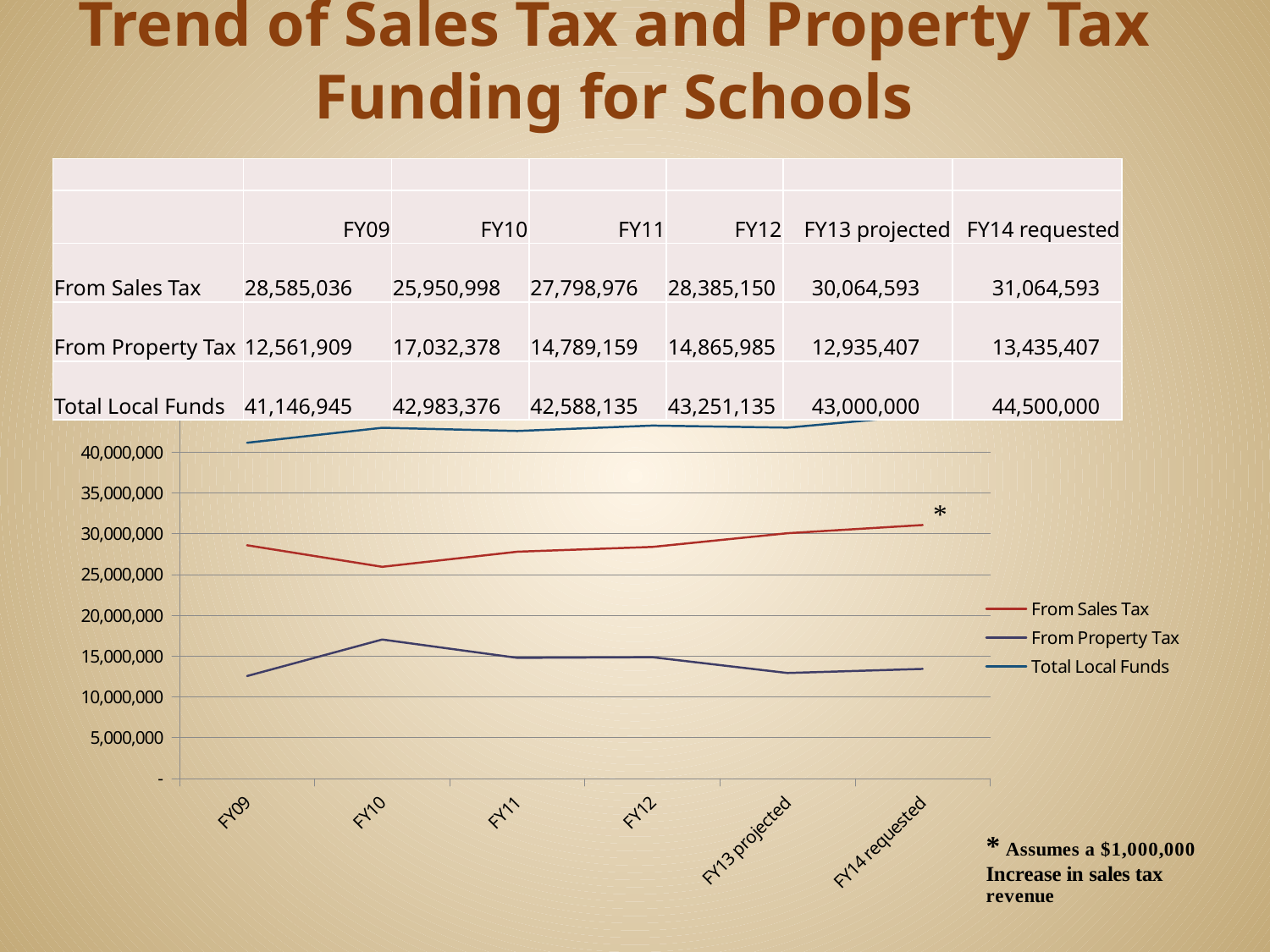
What is the value for From Sales Tax in FY12? 28,385,150 How many fiscal-year categories are plotted along the x axis? 6 In which fiscal year is From Sales Tax lowest? FY10 What is the value for From Property Tax in FY13 projected? 12,935,407 In which fiscal year is From Property Tax highest? FY10 What type of chart is shown on the slide? line chart What is the difference between From Sales Tax in FY14 requested and FY13 projected? 1,000,000 What is the value for Total Local Funds in FY14 requested? 44,500,000 Which is larger, From Sales Tax in FY09 or From Sales Tax in FY10? From Sales Tax in FY09 How many series does the chart legend list? 3 Does the From Sales Tax line rise or fall from FY10 to FY14 requested? rise Is the value for From Property Tax in FY10 greater or less than 15,000,000? greater